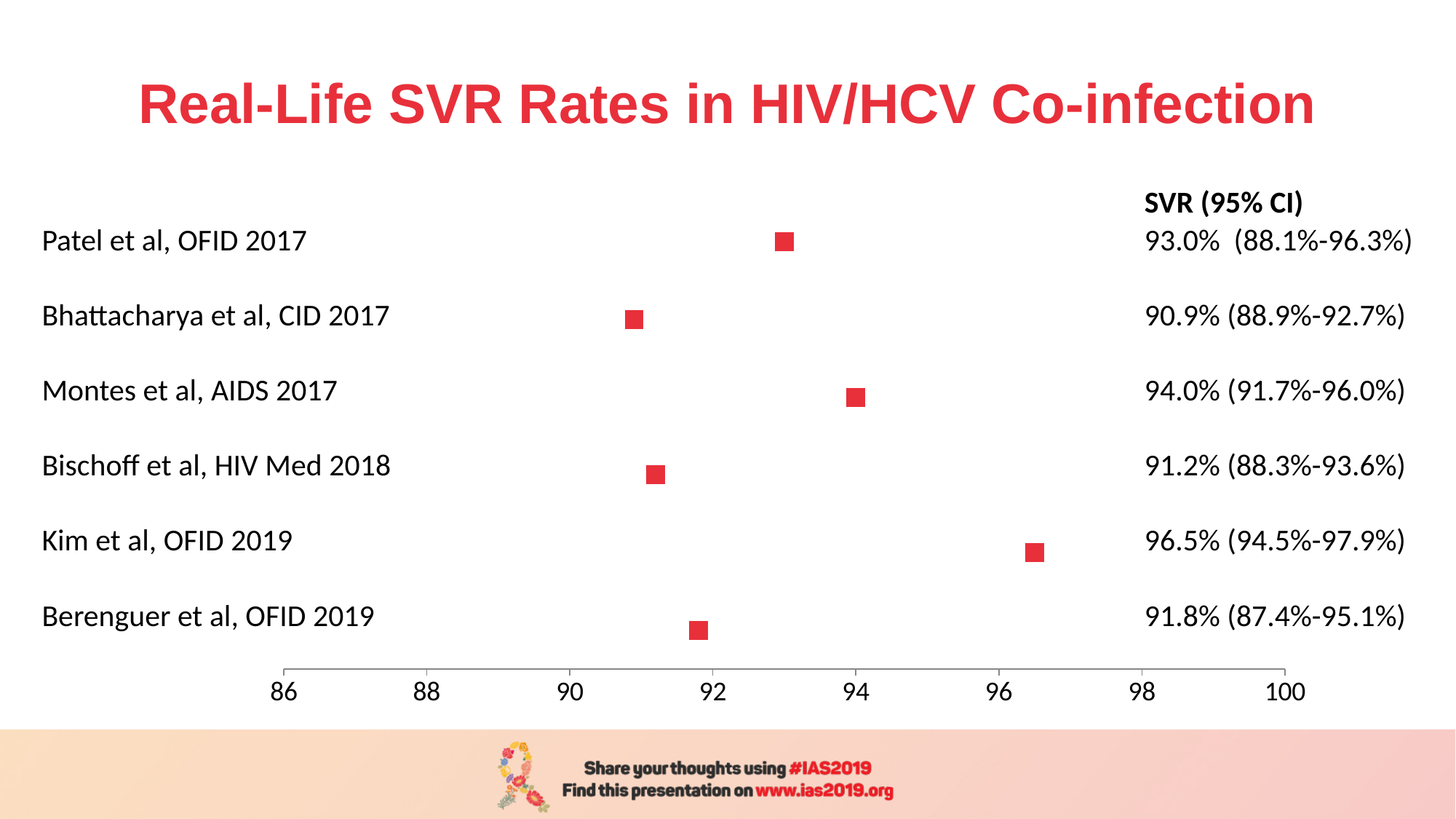
Is the SVR rate for Kim et al, OFID 2019 greater or less than 96? greater What is the 95% CI shown for Patel et al, OFID 2017? 88.1%-96.3% Which study has the highest SVR rate? Kim et al, OFID 2019 What is the difference in SVR rate between Montes et al, AIDS 2017 and Patel et al, OFID 2017? 1.0 percentage point Which study has the lowest SVR rate? Bhattacharya et al, CID 2017 What is the SVR rate for Bhattacharya et al, CID 2017? 90.9% What is the SVR rate for Kim et al, OFID 2019? 96.5% Which has a higher SVR rate, Montes et al, AIDS 2017 or Berenguer et al, OFID 2019? Montes et al, AIDS 2017 What kind of chart is shown on the slide? Dot plot (scatter plot) What is the range of the x axis on the chart? 86 to 100 How many studies are plotted on the chart? 6 What is the difference in SVR rate between Kim et al, OFID 2019 and Bhattacharya et al, CID 2017? 5.6 percentage points